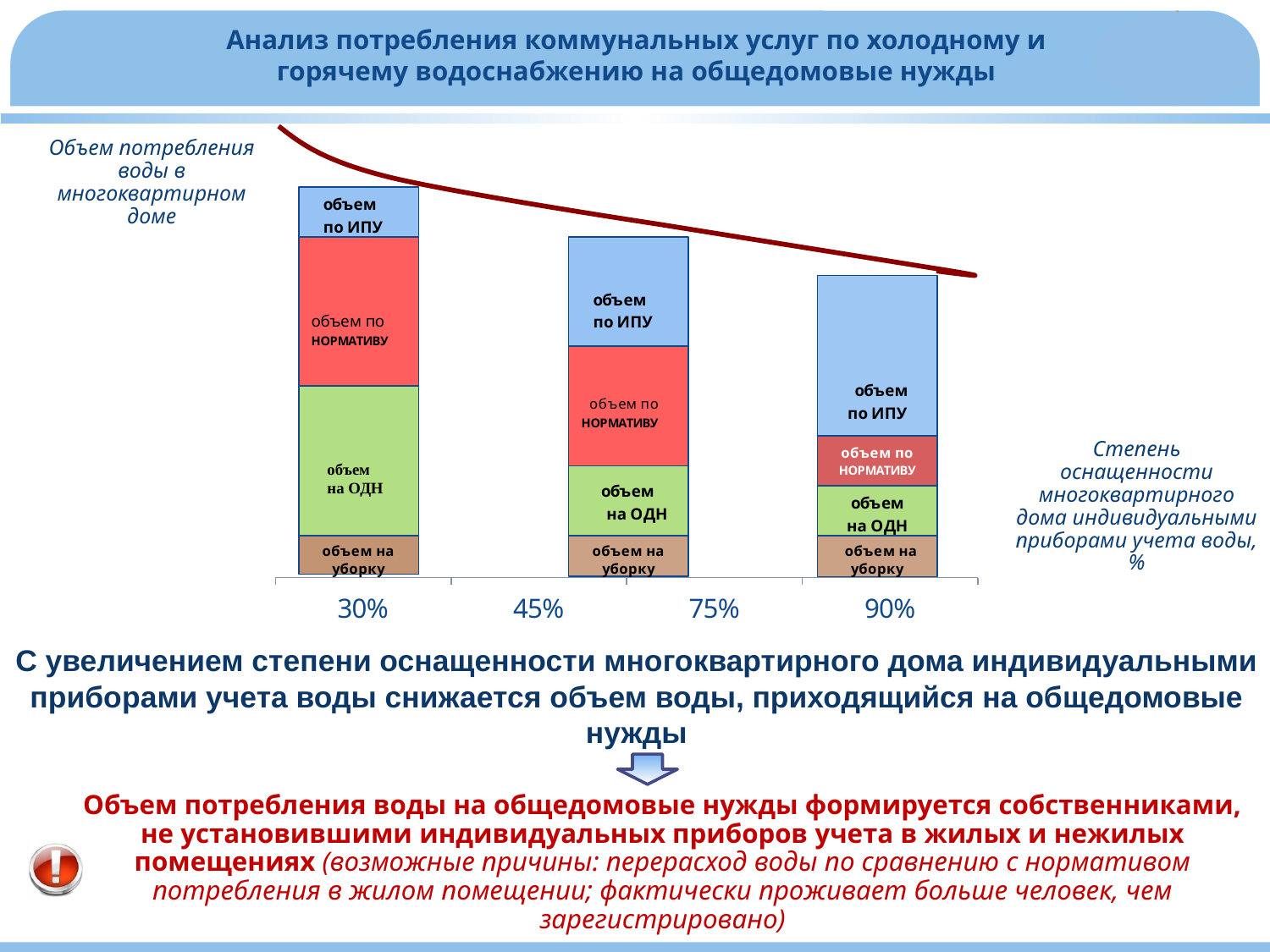
Does the total height of the bars rise or fall as the x-axis value increases? fall How many segments make up each stacked bar? 4 Does the 'объем по ИПУ' segment grow or shrink as the x-axis value increases? grow What kind of chart is shown on the slide? stacked bar chart How many bars are plotted in the chart? 3 In the 30% bar, which is larger: the 'объем по ИПУ' segment or the 'объем на ОДН' segment? объем на ОДН What colour is the 'объем по НОРМАТИВУ' segment? red Which segment is at the bottom of each stacked bar? объем на уборку In the 90% bar, which segment is the largest? объем по ИПУ Which bar is the tallest overall? 30% Which bar is the shortest overall? 90% Does the 'объем на ОДН' segment grow or shrink as the x-axis value increases? shrink